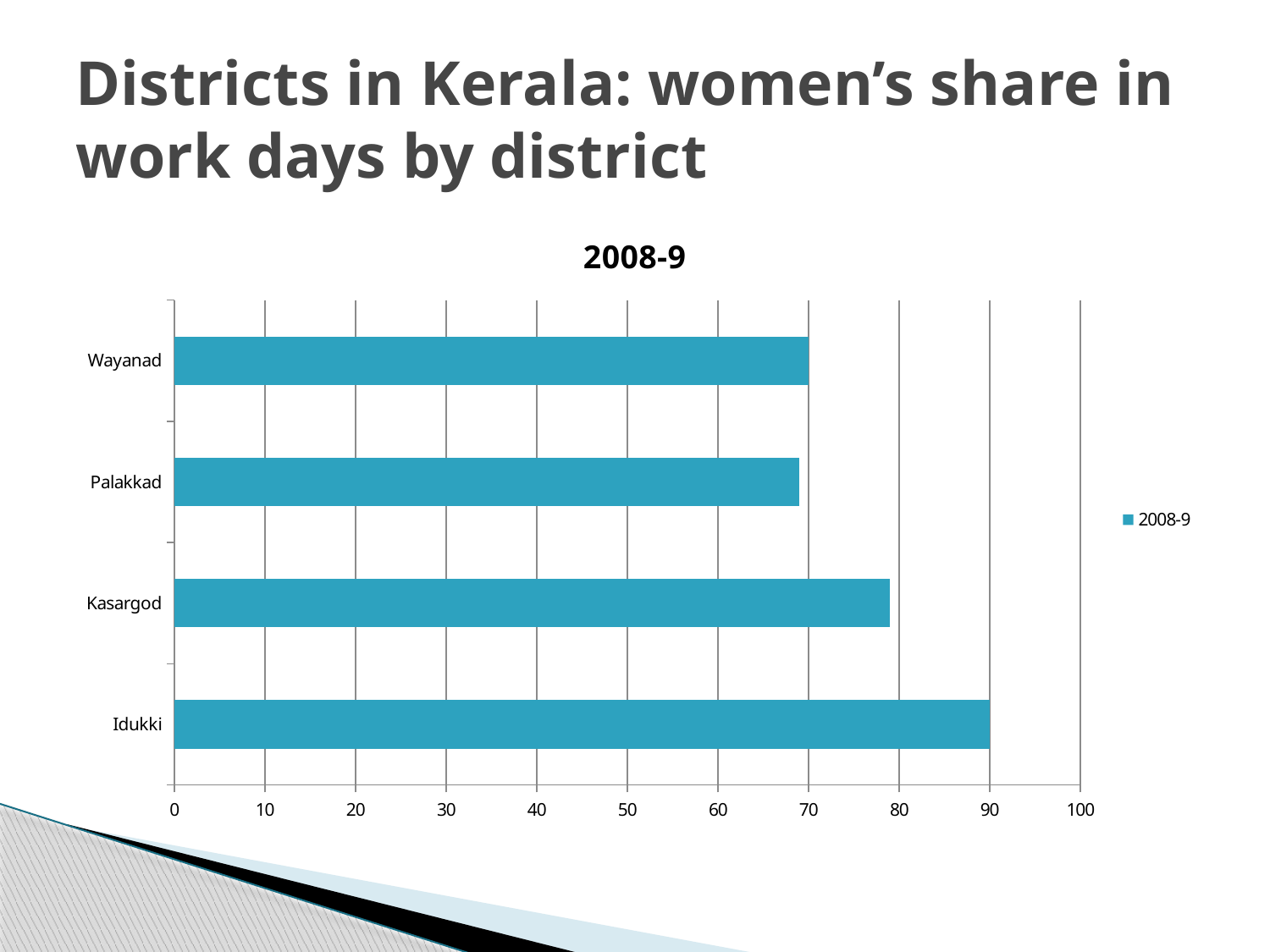
What is the difference between the values for Idukki and Wayanad? 20 What is the value for Idukki? 90 Which is larger, the value for Idukki or the value for Kasargod? Idukki Is the value for Kasargod greater or less than 70? greater What is the title of the chart? 2008-9 What is the value for Wayanad? 70 How many series does the legend list? 1 What type of chart is shown on the slide? bar chart Which district has the highest value? Idukki How many districts are shown in the chart? 4